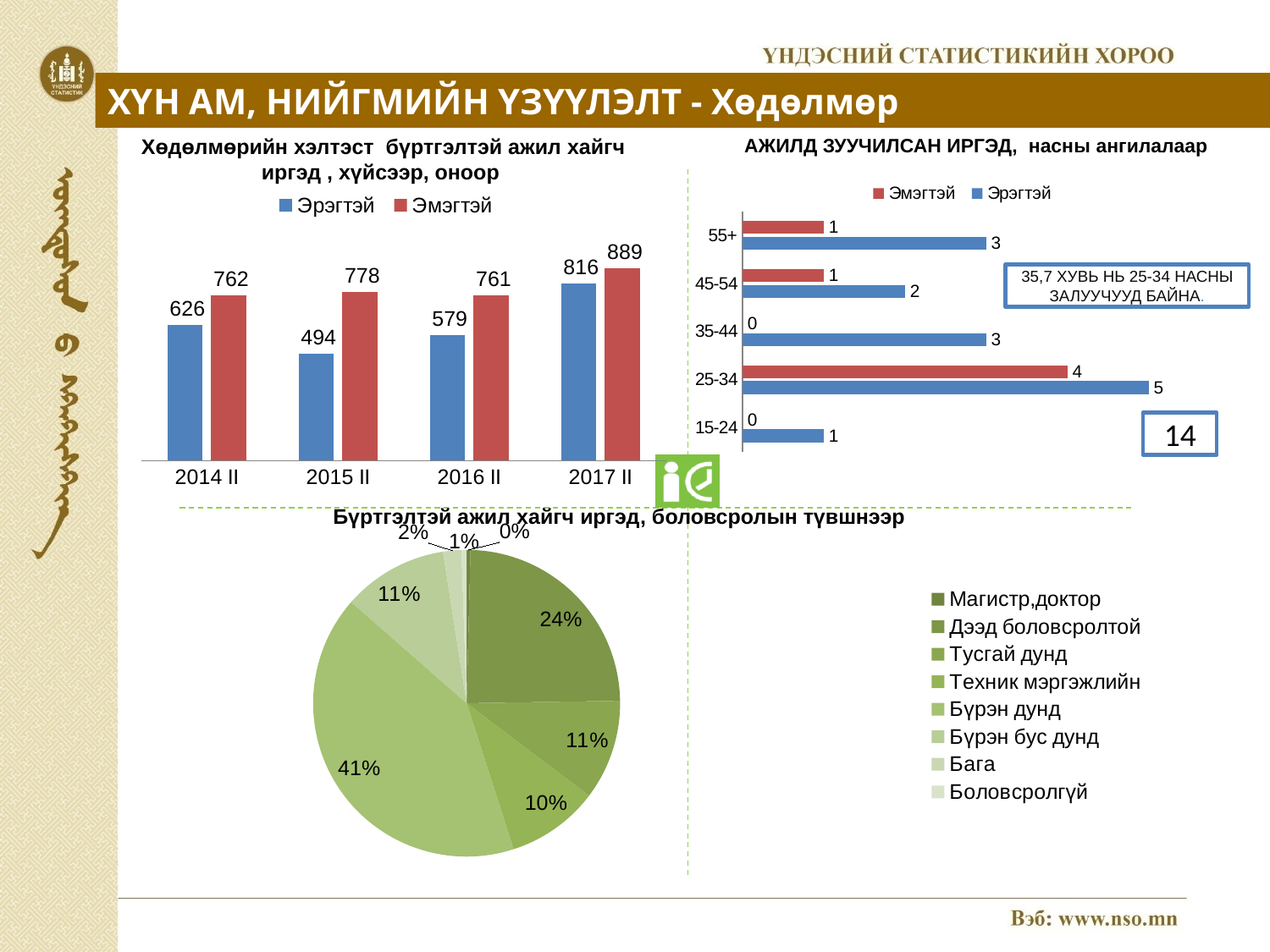
In the top-right chart (АЖИЛД ЗУУЧИЛСАН ИРГЭД, насны ангилалаар), what kind of chart is it? Bar chart In the top-right chart (АЖИЛД ЗУУЧИЛСАН ИРГЭД, насны ангилалаар), which age group has the highest Эмэгтэй value? 25-34 In the top-left chart (Хөдөлмөрийн хэлтэст бүртгэлтэй ажил хайгч иргэд), how many periods are shown on the x axis? 4 In the bottom pie chart (Бүртгэлтэй ажил хайгч иргэд, боловсролын түвшнээр), how many categories does the legend list? 8 In the bottom pie chart (Бүртгэлтэй ажил хайгч иргэд, боловсролын түвшнээр), what is the share of the largest slice? 41% In the top-left chart (Хөдөлмөрийн хэлтэст бүртгэлтэй ажил хайгч иргэд), in which period is the Эрэгтэй value lowest? 2015 II In the top-left chart (Хөдөлмөрийн хэлтэст бүртгэлтэй ажил хайгч иргэд), what is the value for Эмэгтэй in 2015 II? 778 In the top-left chart (Хөдөлмөрийн хэлтэст бүртгэлтэй ажил хайгч иргэд), what is the difference between the Эмэгтэй and Эрэгтэй values in 2014 II? 136 In the top-left chart (Хөдөлмөрийн хэлтэст бүртгэлтэй ажил хайгч иргэд), what is the value for Эрэгтэй in 2017 II? 816 In the top-right chart (АЖИЛД ЗУУЧИЛСАН ИРГЭД, насны ангилалаар), what is the Эмэгтэй value for the 45-54 age group? 1 In the top-right chart (АЖИЛД ЗУУЧИЛСАН ИРГЭД, насны ангилалаар), what is the Эрэгтэй value for the 25-34 age group? 5 In the top-left chart (Хөдөлмөрийн хэлтэст бүртгэлтэй ажил хайгч иргэд), how many series does the legend list? 2